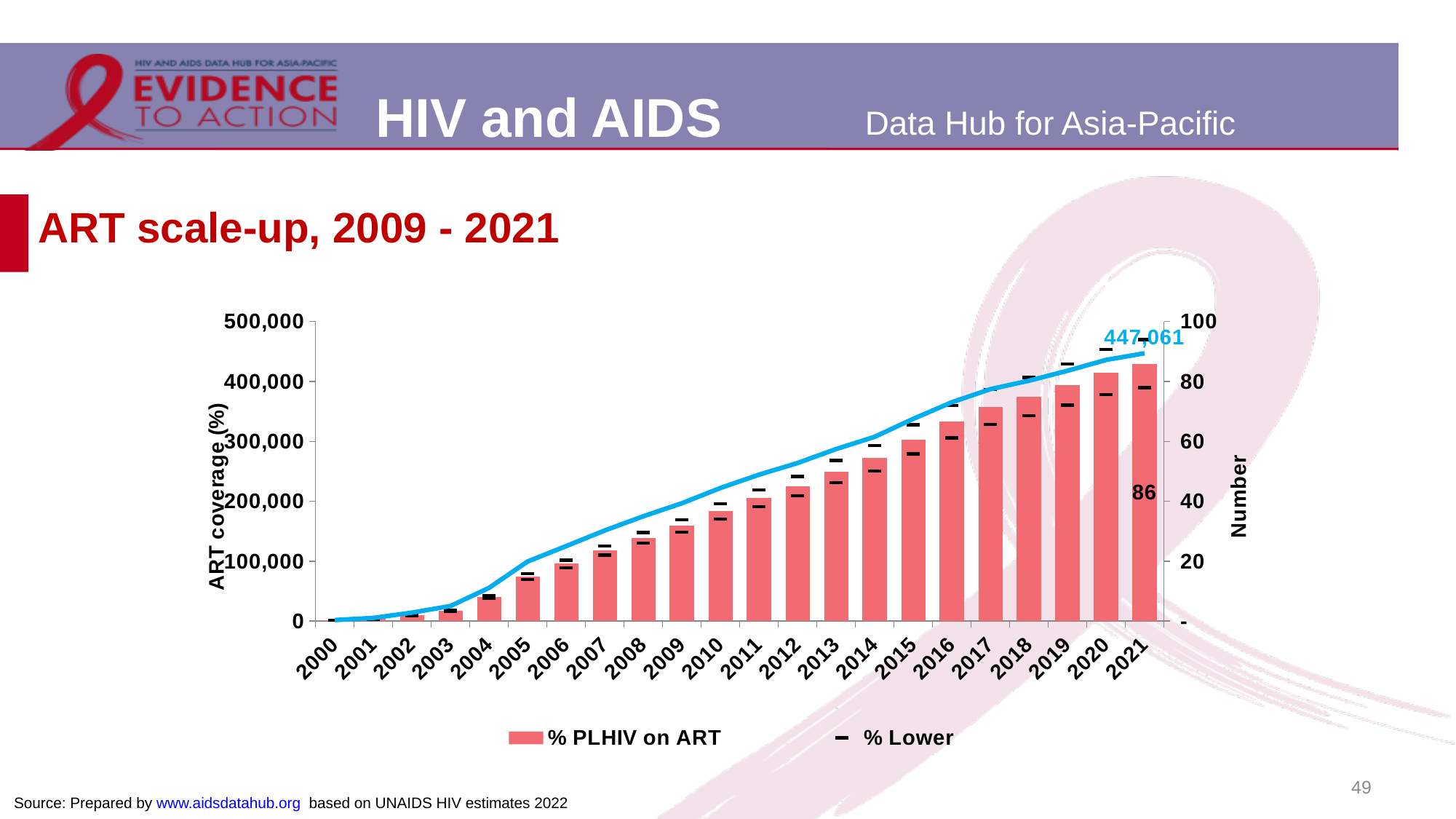
Which year has the lowest % PLHIV on ART bar? 2000 How many series does the legend list? 2 Which year has the highest % PLHIV on ART bar? 2021 What is the data label shown on the 2021 bar for % PLHIV on ART? 86 What is the title of the chart on the slide? ART scale-up, 2009 - 2021 Is the % PLHIV on ART bar for 2020 greater or less than 80 on the right axis? greater Is the % PLHIV on ART bar for 2005 greater or less than 20 on the right axis? less Do the % PLHIV on ART bars rise or fall from 2000 to 2021? rise How many years are shown on the x axis? 22 Which year has the larger % PLHIV on ART bar, 2015 or 2019? 2019 What kind of chart is shown on the slide? bar chart with a line What value is labelled on the blue line at 2021? 447,061